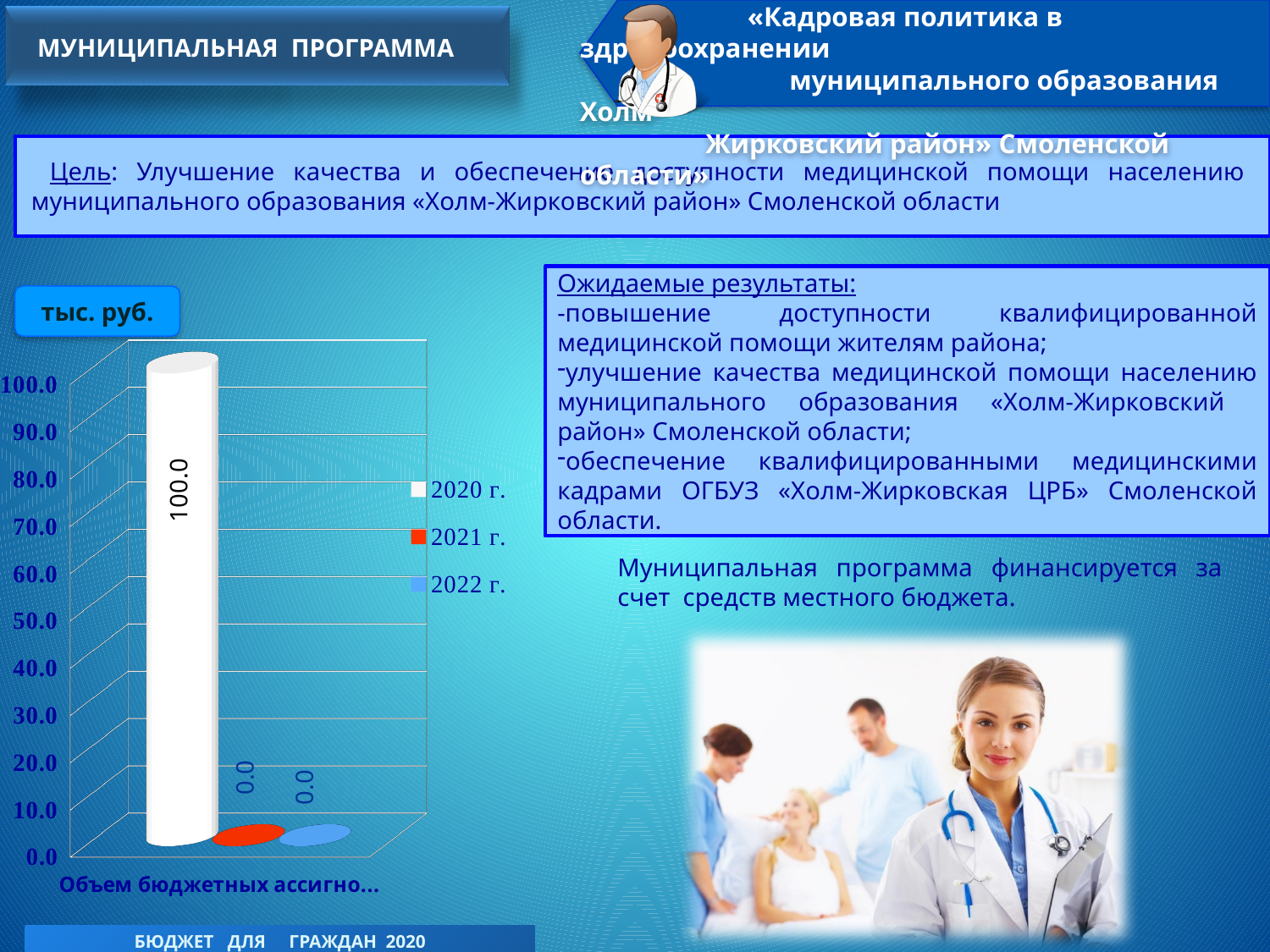
Which series has the highest value in the chart? 2020 г. What is the value for the 2021 г. series in the chart? 0.0 How many series does the chart legend list? 3 What is the value for the 2020 г. series in the chart? 100.0 What unit of measurement is indicated for the chart? тыс. руб. Which is larger, the value for 2020 г. or the value for 2022 г.? 2020 г. What colour is used for the 2021 г. series in the chart legend? red What is the highest value shown on the chart's vertical axis? 100.0 What is the difference between the 2020 г. value and the 2021 г. value? 100.0 What type of chart is shown on the slide? bar chart What is the value for the 2022 г. series in the chart? 0.0 Is the value for 2020 г. greater or less than 50.0? greater